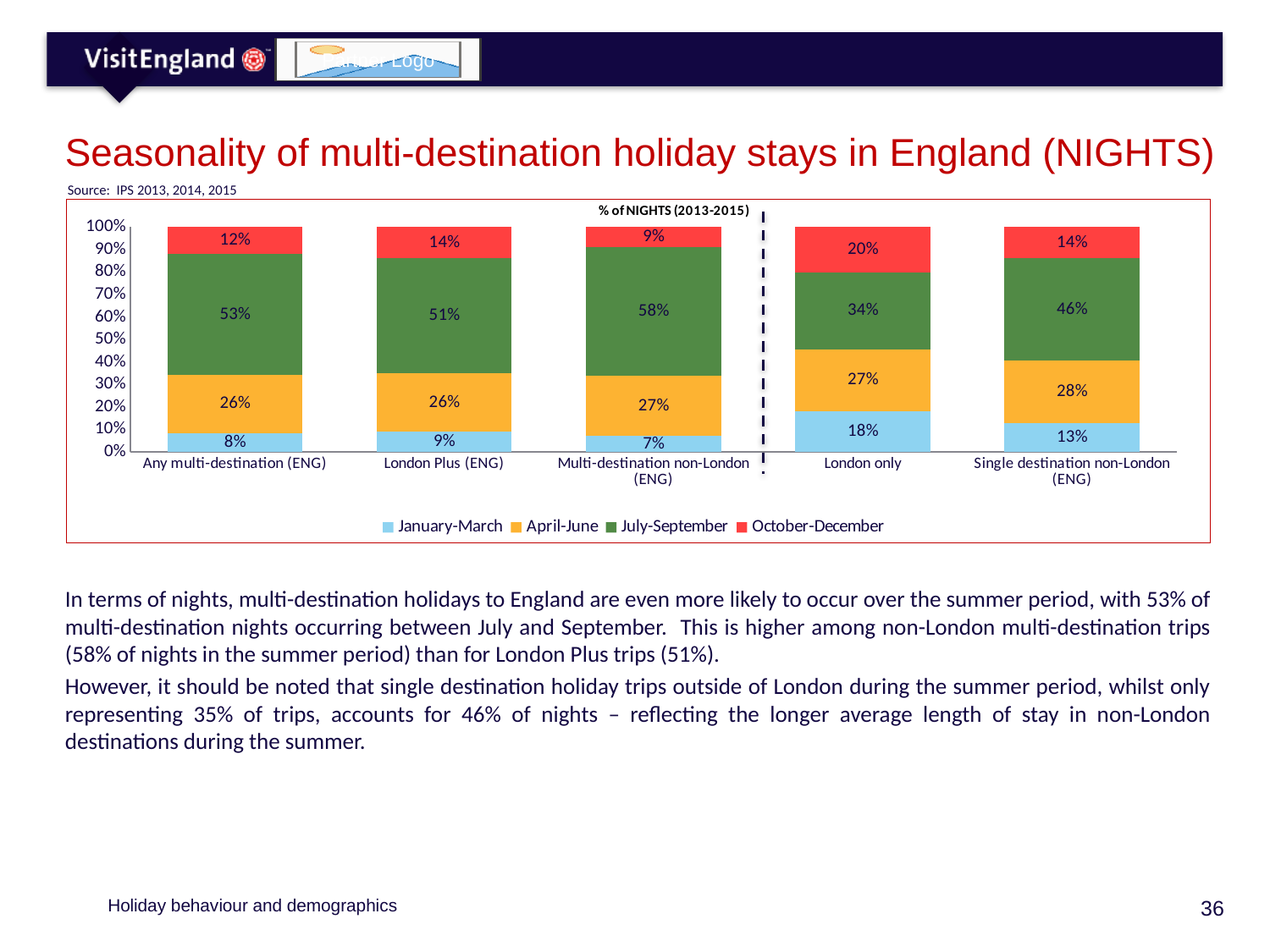
What kind of chart is shown? Stacked bar chart Which is larger: the October-December share for London only or for Any multi-destination (ENG)? London only What is the difference between the July-September share for Multi-destination non-London (ENG) and London Plus (ENG)? 7% Which category has the highest July-September share of nights? Multi-destination non-London (ENG) Which category has the lowest January-March share of nights? Multi-destination non-London (ENG) What is the October-December share of nights for London Plus (ENG)? 14% What is the April-June share of nights for Single destination non-London (ENG)? 28% What is the January-March share of nights for London only? 18% What is the July-September share of nights for Multi-destination non-London (ENG)? 58% How many categories are shown on the x axis? 5 How many series does the legend list? 4 Which legend entry is shown in green? July-September